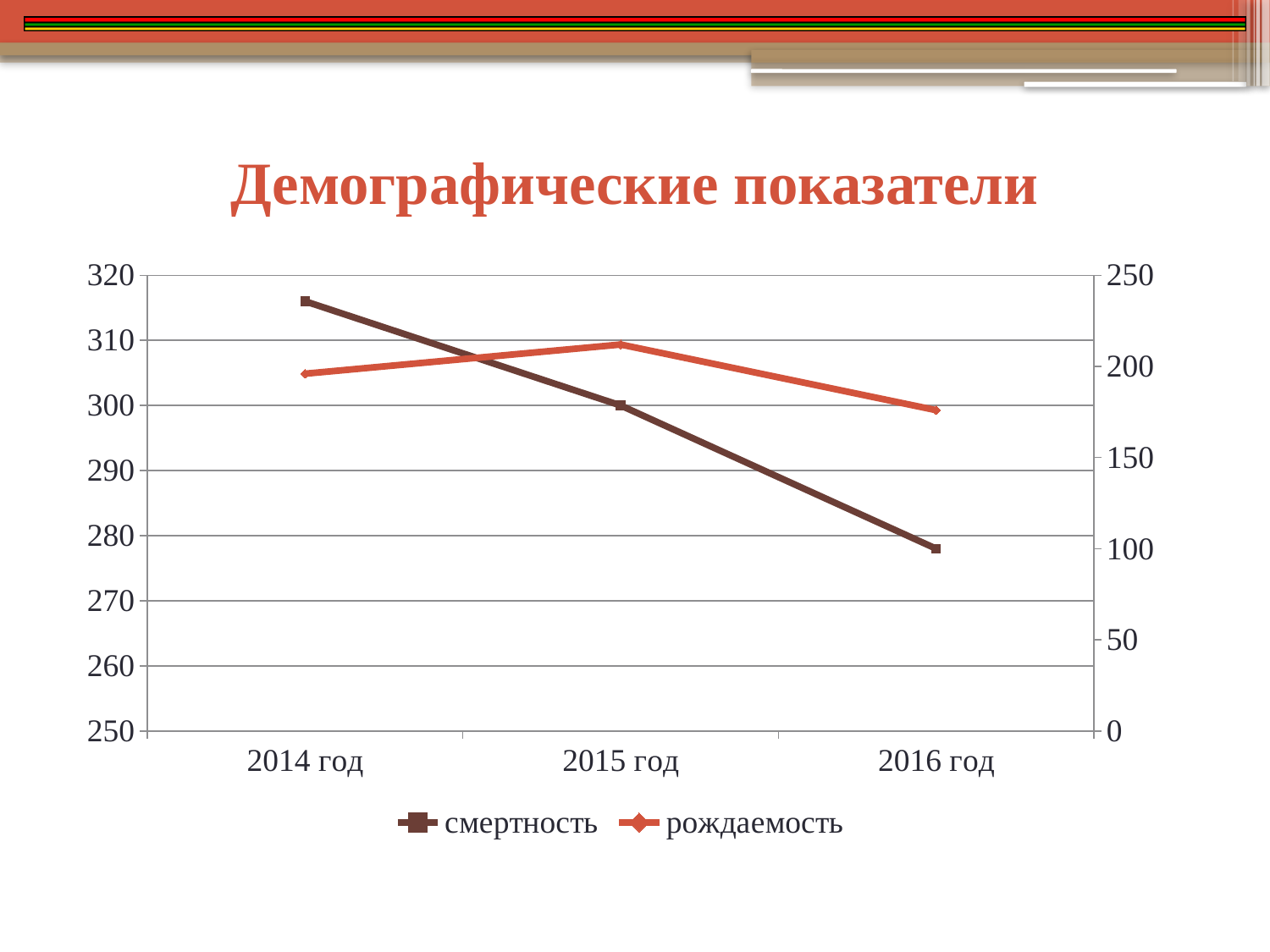
How many series does the legend list? 2 In which year is рождаемость highest? 2015 год Is the value for смертность in 2014 год greater or less than 310 on the left axis? greater What kind of chart is shown on the slide? line chart Is the value for рождаемость in 2015 год greater or less than 200 on the right axis? greater Does the смертность line rise or fall from 2014 год to 2016 год? falls In which year is рождаемость lowest? 2016 год In which year is смертность highest? 2014 год What is the title of the slide above the chart? Демографические показатели How many years are plotted along the x axis? 3 In which year is смертность lowest? 2016 год Is the value for смертность in 2016 год greater or less than 280 on the left axis? less